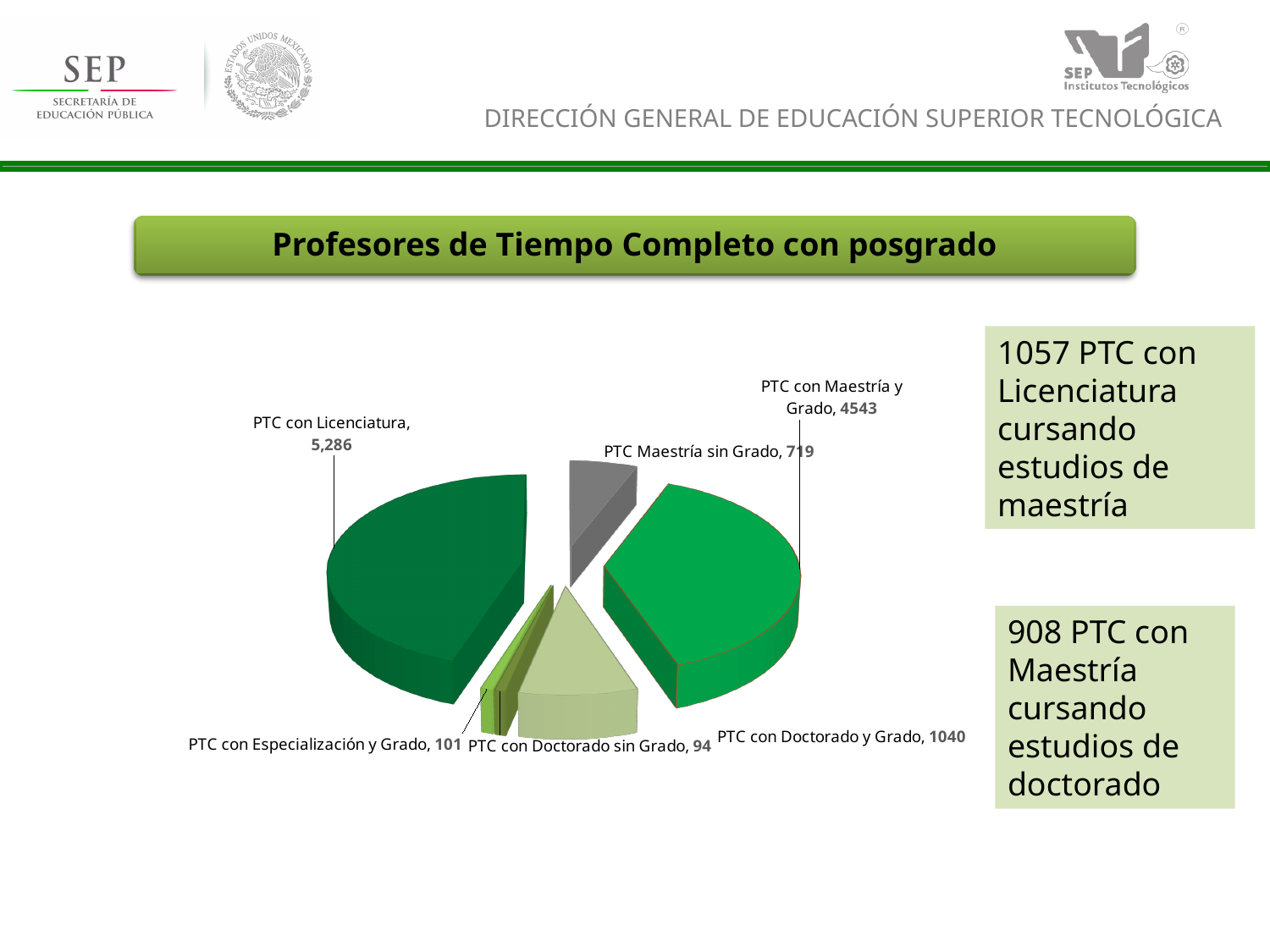
What is the value for PTC con Doctorado y Grado? 1040 What is the title shown above the chart? Profesores de Tiempo Completo con posgrado What kind of chart is shown on the slide? pie chart Which is larger, PTC con Especialización y Grado or PTC con Doctorado sin Grado? PTC con Especialización y Grado What is the value for PTC con Maestría y Grado? 4543 What is the value for PTC Maestría sin Grado? 719 Which category has the largest slice of the pie? PTC con Licenciatura What is the difference between PTC con Licenciatura and PTC con Maestría y Grado? 743 How many categories does the pie chart show? 6 Which category has the smallest slice of the pie? PTC con Doctorado sin Grado What is the value for PTC con Licenciatura? 5,286 What is the difference between PTC con Doctorado y Grado and PTC Maestría sin Grado? 321